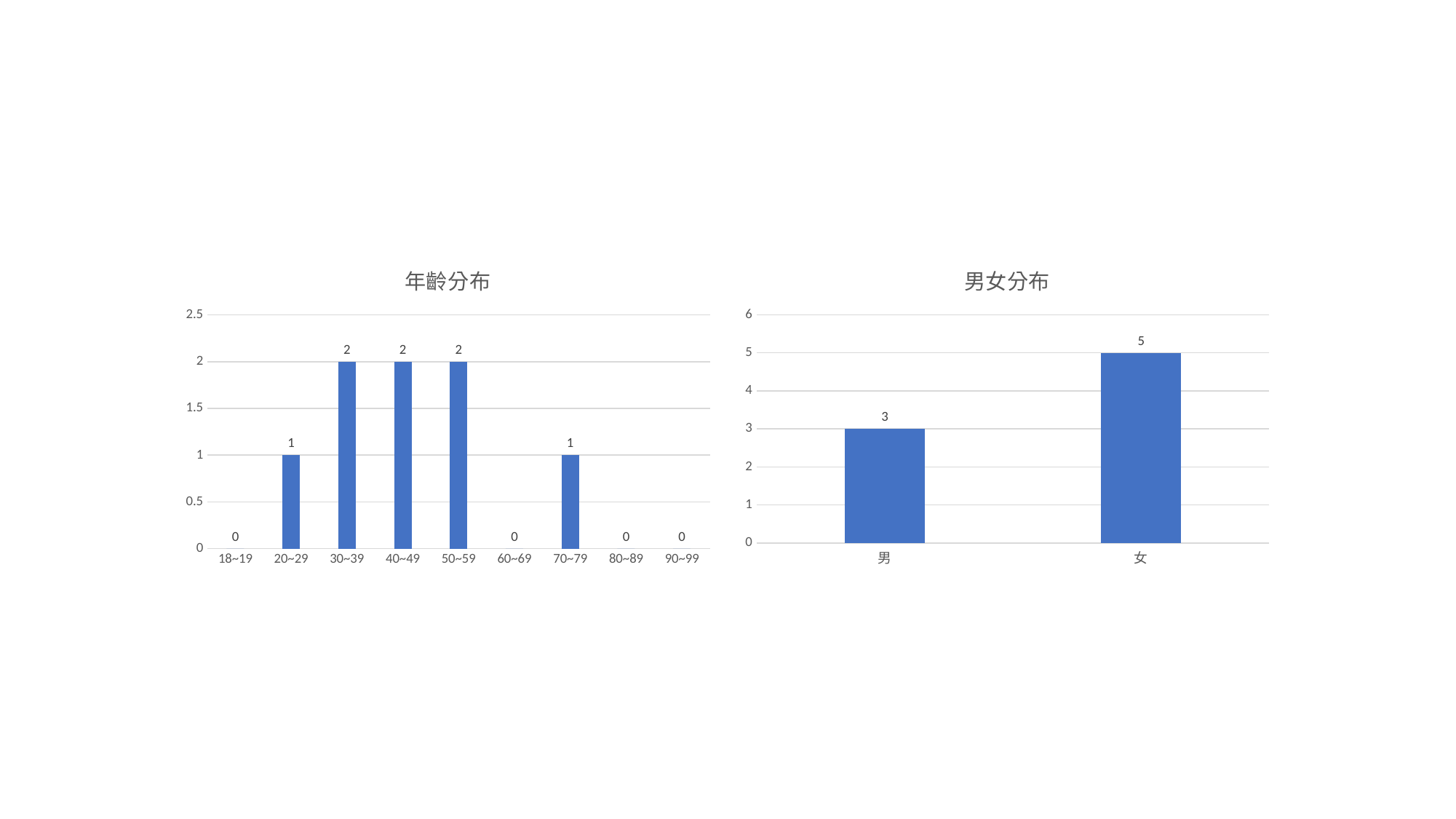
In the 年齡分布 chart, what is the value for 30~39? 2 In the 年齡分布 chart, which is larger, the value for 40~49 or the value for 70~79? 40~49 In the 年齡分布 chart, what is the value for 60~69? 0 What kind of chart is the 年齡分布 chart? bar chart In the 男女分布 chart, what is the difference between the values for 女 and 男? 2 In the 年齡分布 chart, what is the difference between the values for 50~59 and 20~29? 1 In the 男女分布 chart, what is the value for 女? 5 In the 男女分布 chart, which category has the highest value? 女 In the 年齡分布 chart, what is the value for 70~79? 1 In the 男女分布 chart, what is the value for 男? 3 In the 年齡分布 chart, how many age categories are shown on the x axis? 9 What is the title of the chart on the right side of the slide? 男女分布